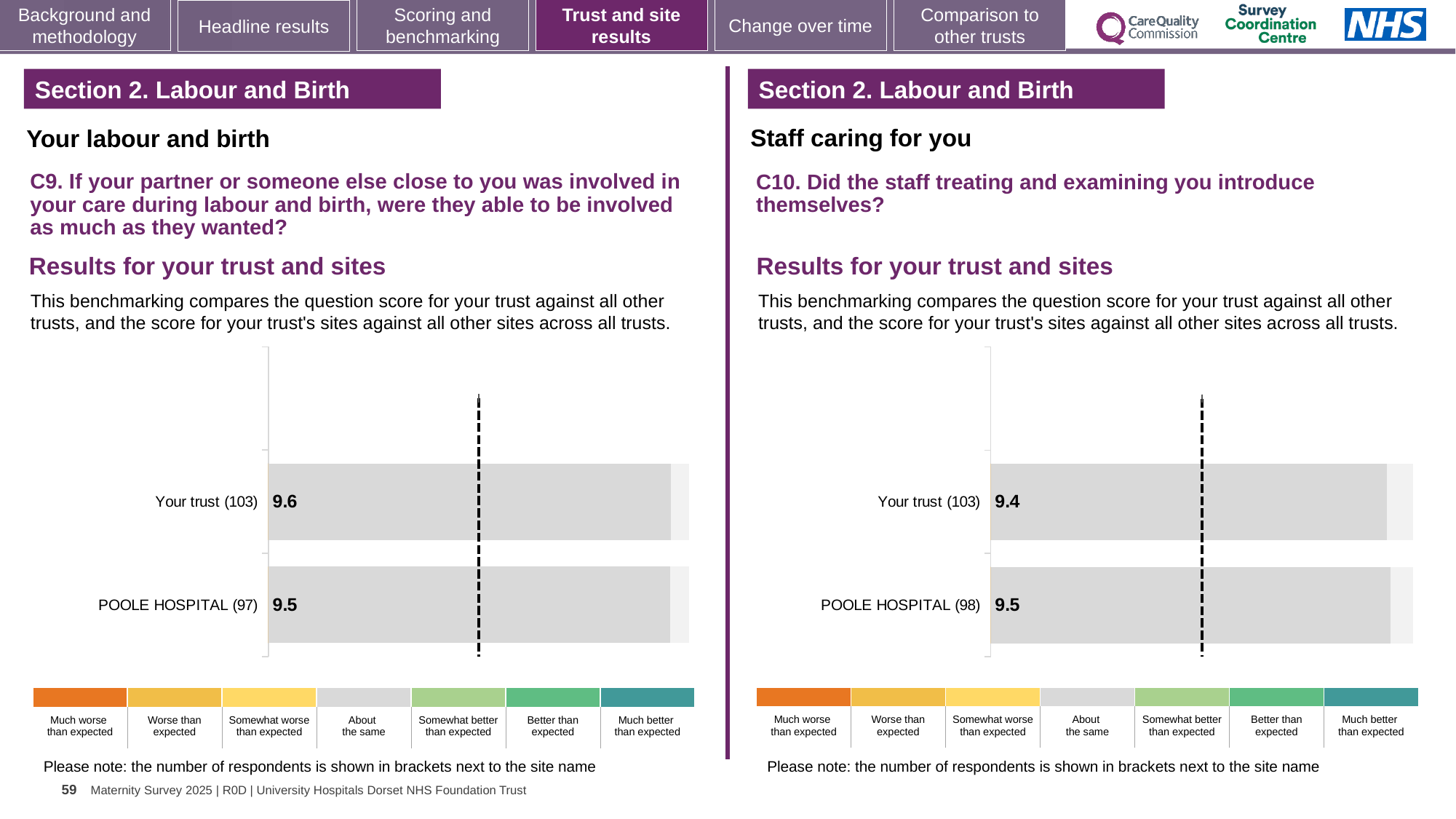
In the C10 chart on the right, what is the score for Your trust (103)? 9.4 In the C10 chart on the right, how many respondents are shown in brackets for POOLE HOSPITAL? 98 In the C9 chart on the left, what is the difference between the Your trust score and the POOLE HOSPITAL score? 0.1 In the C9 chart on the left, what is the score for POOLE HOSPITAL (97)? 9.5 In the C9 chart on the left, what is the score for Your trust (103)? 9.6 In the C10 chart on the right, what is the score for POOLE HOSPITAL (98)? 9.5 In the C10 chart on the right, which has the higher score, Your trust or POOLE HOSPITAL? POOLE HOSPITAL How many categories does the colour legend below the C9 chart on the left list? 7 How many bars are plotted in the C9 chart on the left? 2 What type of chart is used in the C10 chart on the right? Bar chart In the C9 chart on the left, which has the higher score, Your trust or POOLE HOSPITAL? Your trust In the C10 chart on the right, what is the difference between the POOLE HOSPITAL score and the Your trust score? 0.1